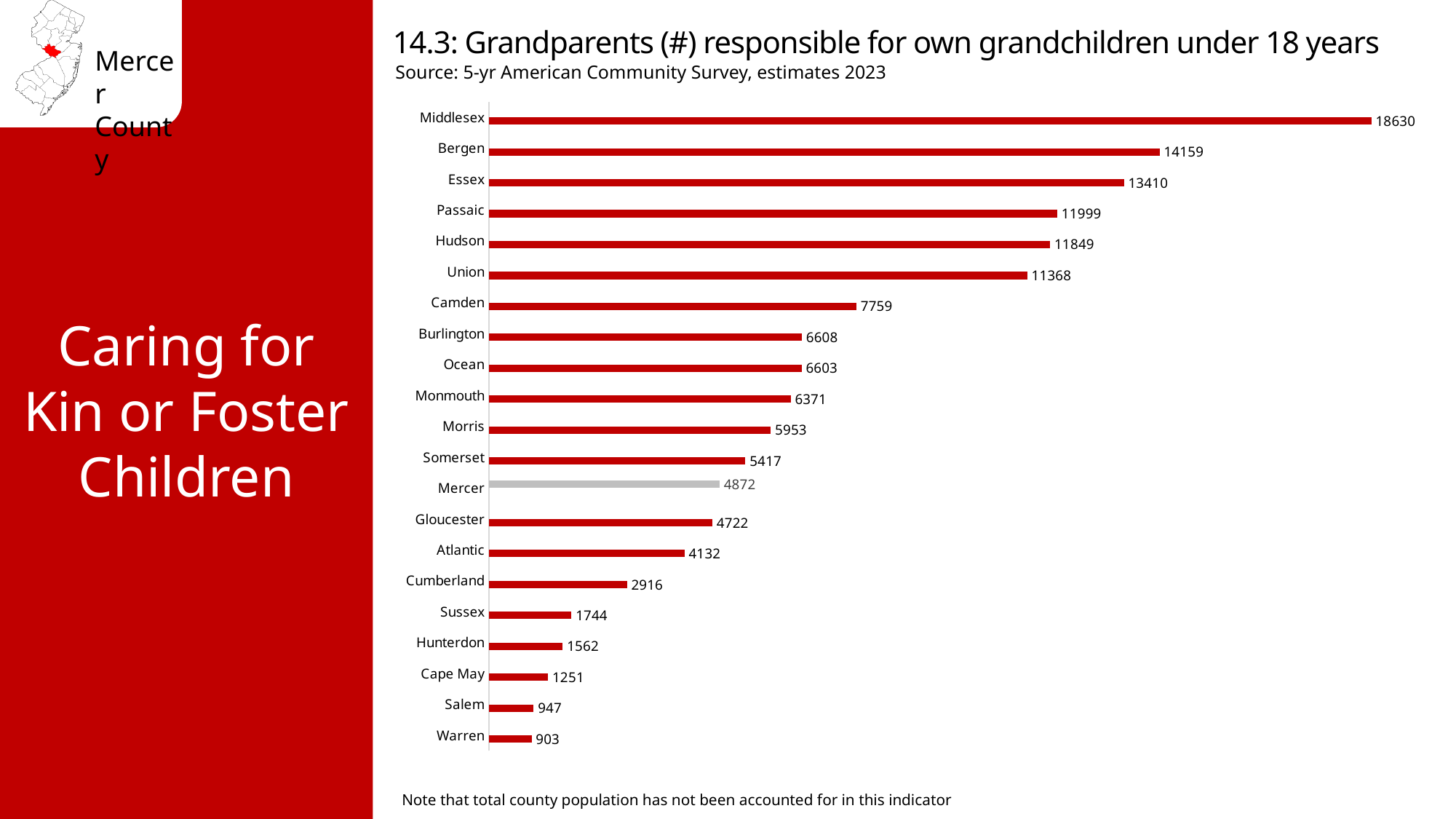
How many counties are shown in the chart? 21 What kind of chart is shown on the slide? Bar chart What is the value for Mercer? 4872 Which county has the highest value? Middlesex What is the value for Cumberland? 2916 What is the difference between the values for Mercer and Gloucester? 150 What is the difference between the values for Bergen and Essex? 749 Which county has the lowest value? Warren Which is larger, the value for Camden or the value for Morris? Camden Which is larger, the value for Sussex or the value for Cape May? Sussex What is the value for Middlesex? 18630 Which county's bar is shown in grey rather than red? Mercer